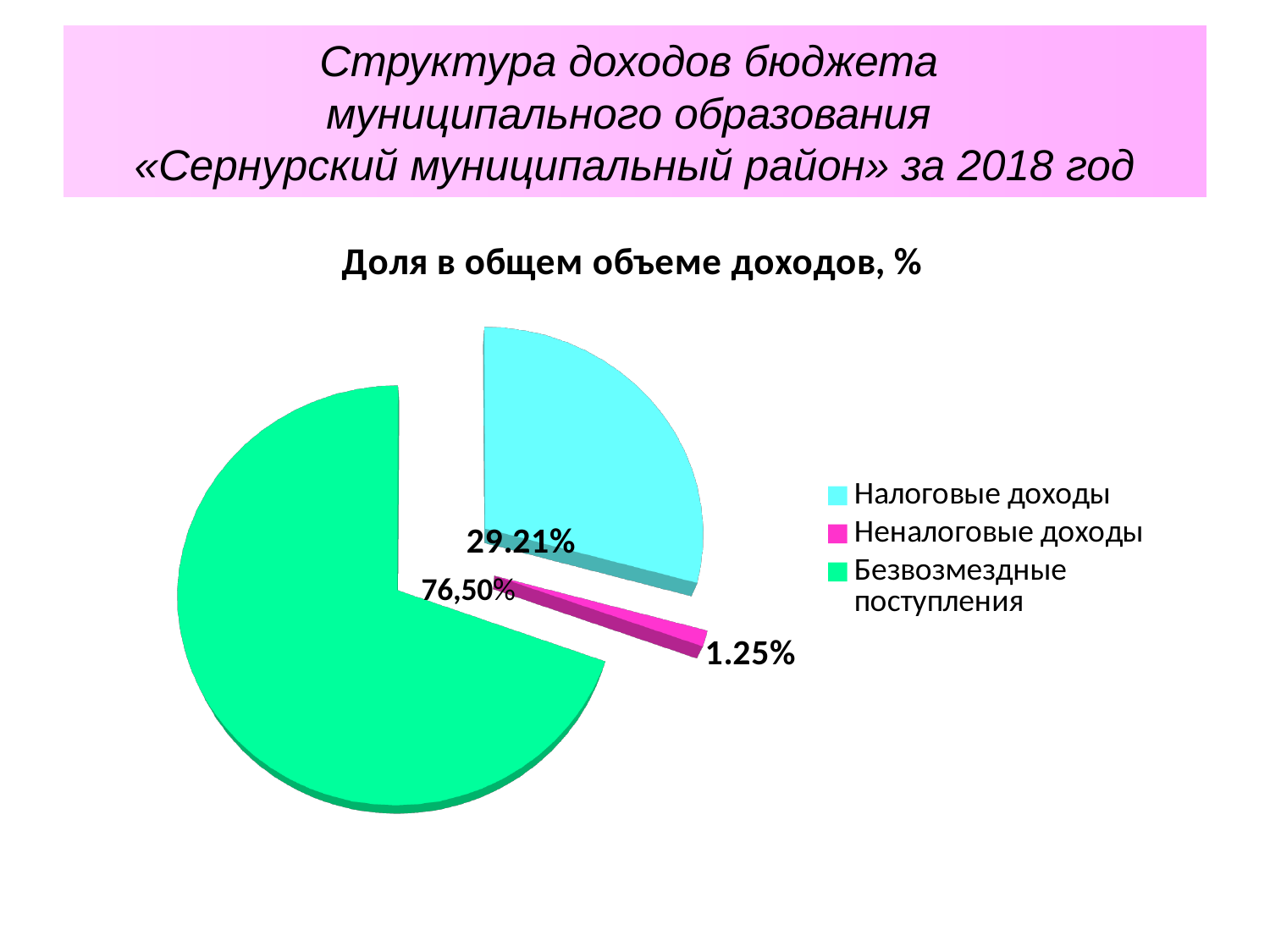
What is the chart's title? Доля в общем объеме доходов, % How many entries does the legend list? 3 Which category has the smallest slice of the pie? Неналоговые доходы What share is shown for Безвозмездные поступления? 76,50% How many slices does the pie chart have? 3 By how many percentage points does the share for Налоговые доходы exceed the share for Неналоговые доходы? 27.96 What share is shown for Налоговые доходы? 29.21% Which colour represents Безвозмездные поступления in the legend? Green Which category has the largest slice of the pie? Безвозмездные поступления What kind of chart is shown on the slide? Pie chart What share is shown for Неналоговые доходы? 1.25% Which is larger, the share for Налоговые доходы or the share for Неналоговые доходы? Налоговые доходы